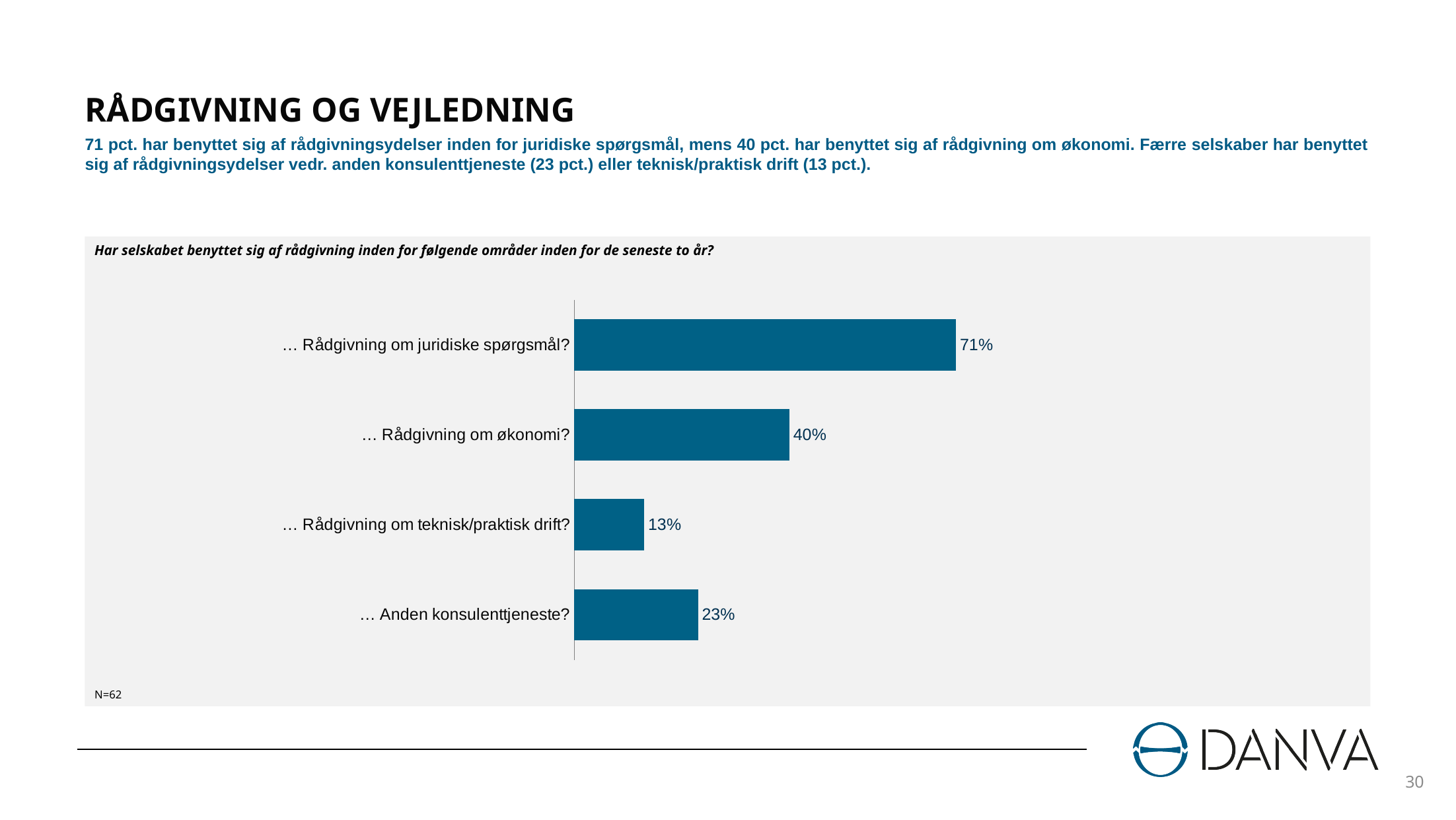
Which is larger: the value for "… Anden konsulenttjeneste?" or "… Rådgivning om teknisk/praktisk drift?"? … Anden konsulenttjeneste? What is the value for "… Rådgivning om økonomi?"? 40% Which category has the lowest value? … Rådgivning om teknisk/praktisk drift? What is the difference between the values for "… Anden konsulenttjeneste?" and "… Rådgivning om teknisk/praktisk drift?"? 10% What sample size (N) is stated below the chart? N=62 What is the value for "… Rådgivning om juridiske spørgsmål?"? 71% What is the value for "… Anden konsulenttjeneste?"? 23% What is the difference between the values for "… Rådgivning om juridiske spørgsmål?" and "… Rådgivning om økonomi?"? 31% How many categories are shown in the chart? 4 What is the value for "… Rådgivning om teknisk/praktisk drift?"? 13% Which category has the highest value? … Rådgivning om juridiske spørgsmål? What kind of chart is shown on the slide? Bar chart